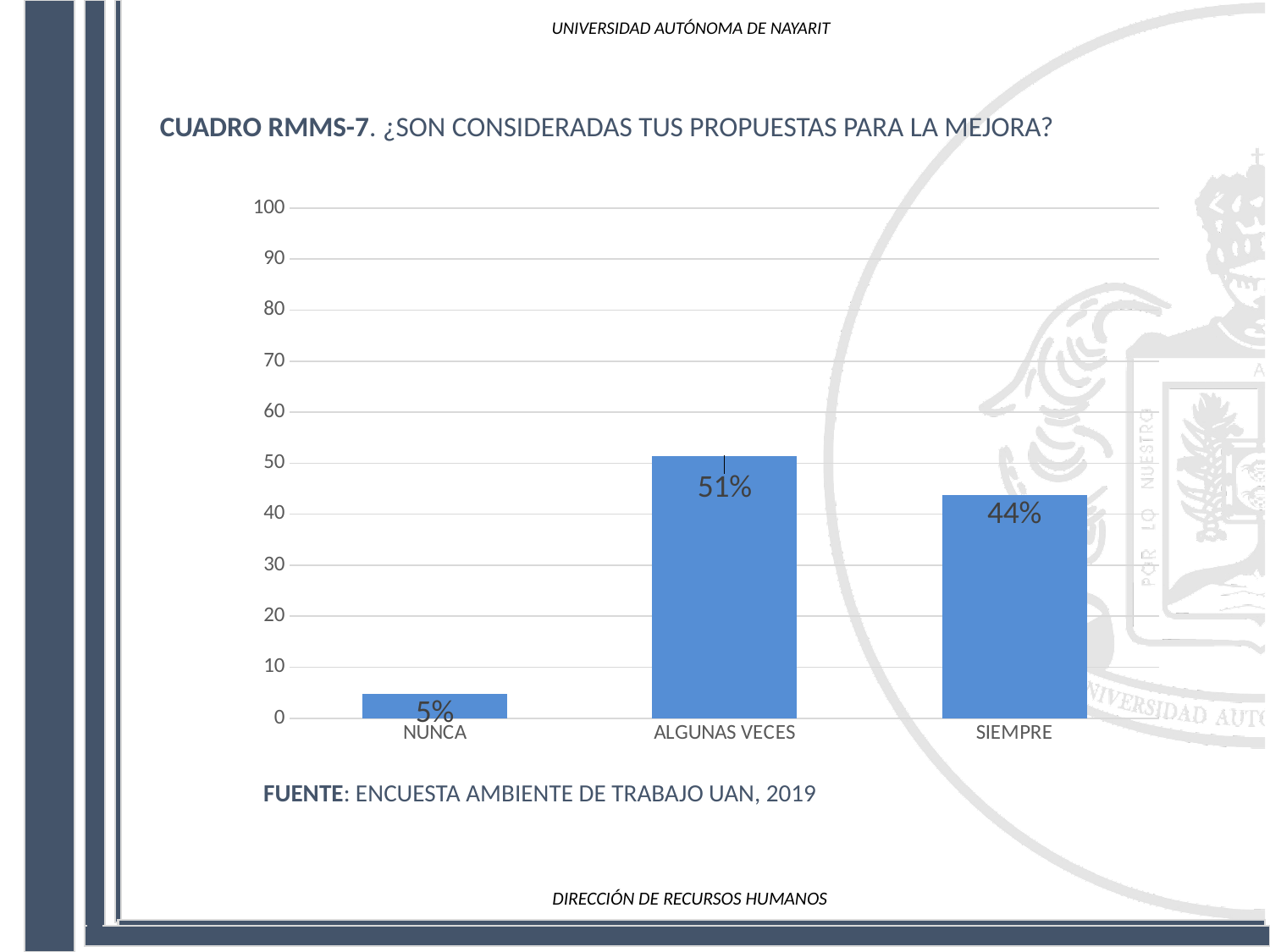
Is the value for SIEMPRE greater or less than 50? less What is the value for NUNCA? 5% What is the value for ALGUNAS VECES? 51% Which category has the lowest value? NUNCA Which category has the highest value? ALGUNAS VECES What source is cited below the chart? ENCUESTA AMBIENTE DE TRABAJO UAN, 2019 What kind of chart is shown on the slide? bar chart How many categories are shown on the x axis? 3 Which is larger, the value for SIEMPRE or the value for NUNCA? SIEMPRE What is the value for SIEMPRE? 44% What is the difference between the values for ALGUNAS VECES and SIEMPRE? 7% What is the difference between the values for SIEMPRE and NUNCA? 39%